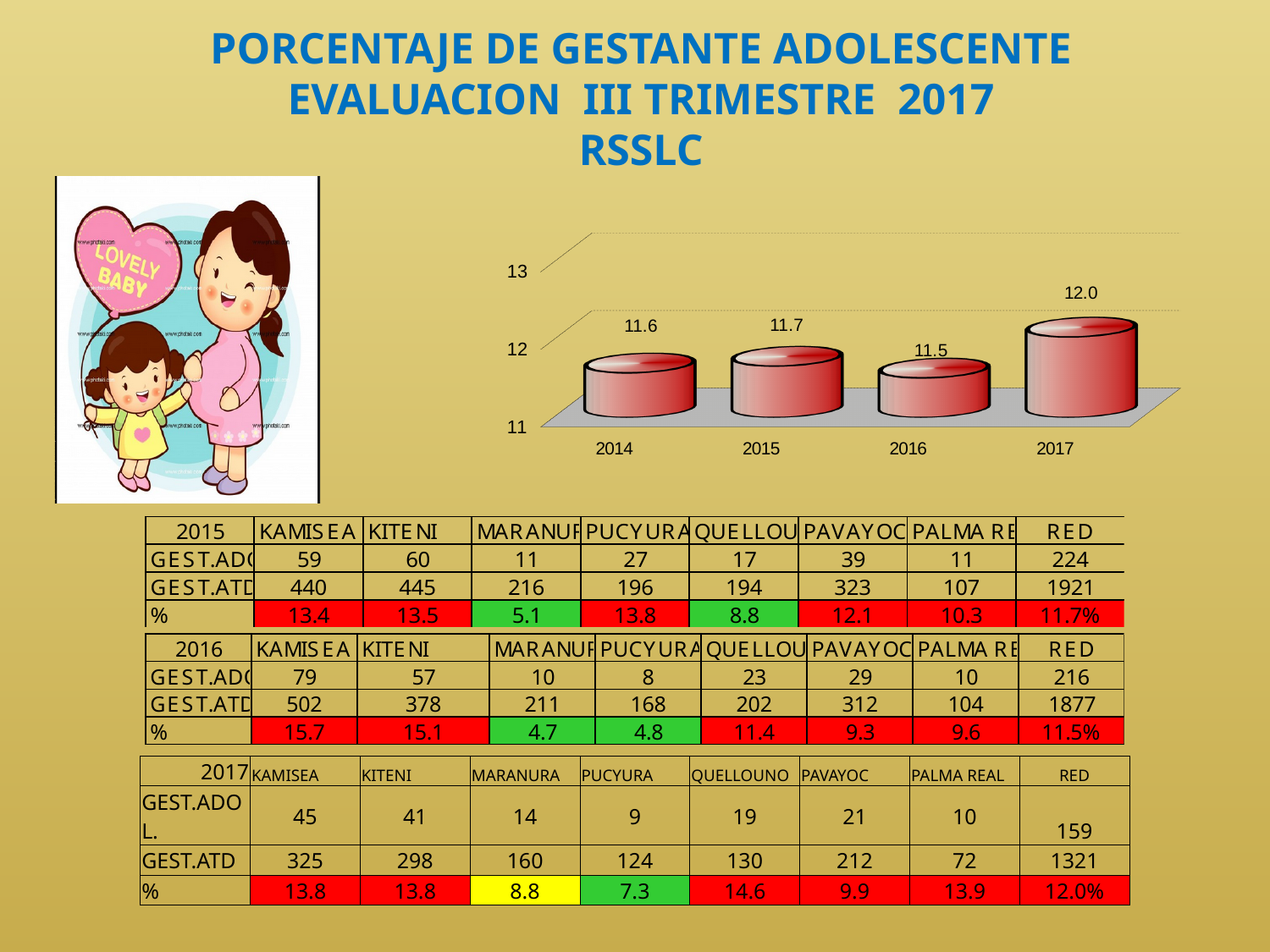
What is the value for 2017 in the chart? 12.0 What is the value for 2014 in the chart? 11.6 Which is larger in the chart, the value for 2015 or the value for 2016? 2015 Which year has the lowest value in the chart? 2016 Which year has the highest value in the chart? 2017 How many years are plotted in the chart? 4 Is the value for 2017 in the chart greater or less than 13? less What is the value for 2015 in the chart? 11.7 What is the value for 2016 in the chart? 11.5 What is the difference between the values for 2015 and 2014 in the chart? 0.1 What is the difference between the values for 2017 and 2016 in the chart? 0.5 What kind of chart is shown on the slide? bar chart